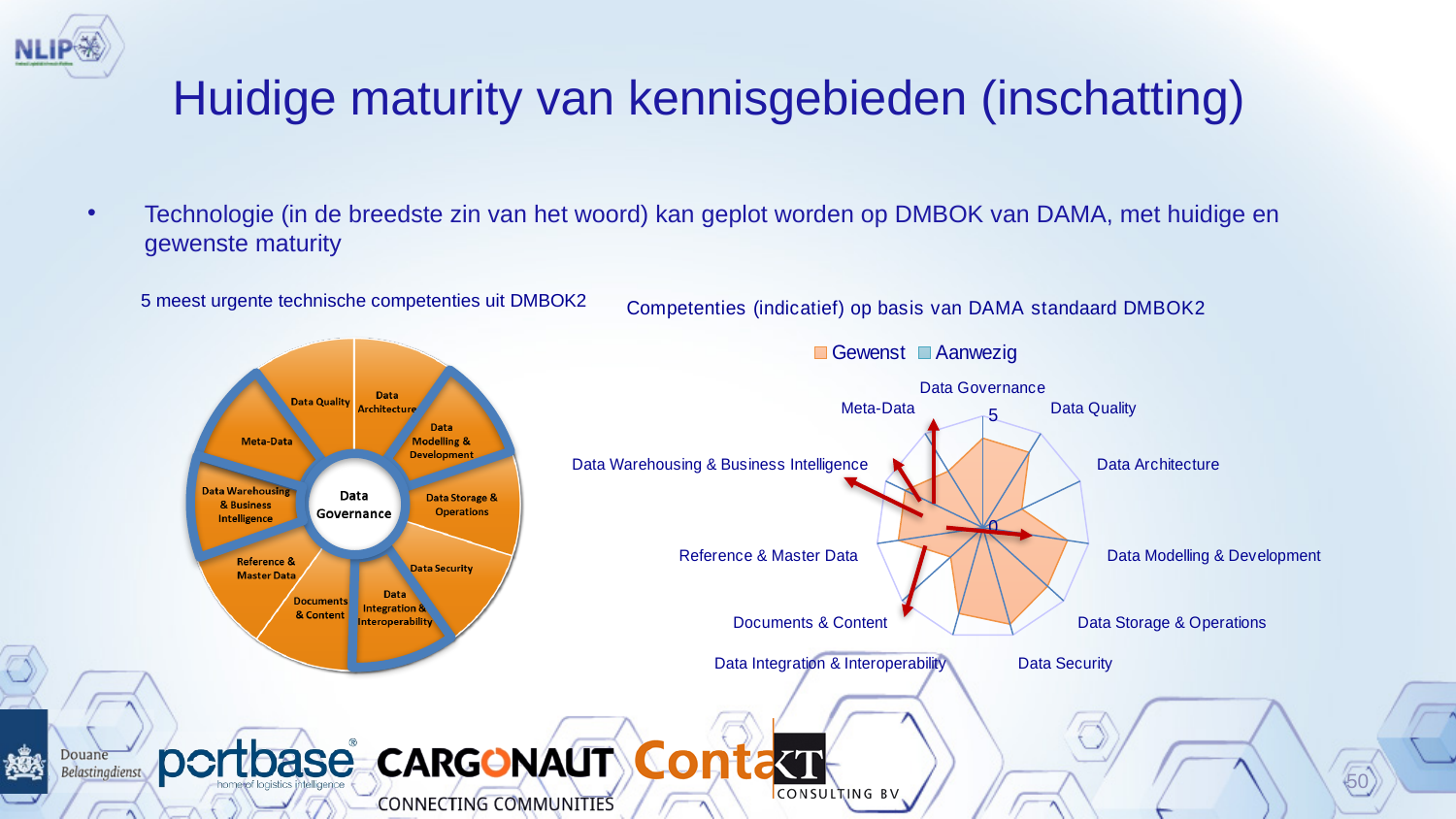
What kind of chart is the chart titled 'Competenties (indicatief) op basis van DAMA standaard DMBOK2'? Radar chart What is the maximum value shown on the axis of the radar chart? 5 What is the minimum value shown on the axis of the radar chart? 0 What are the two series named in the legend of the radar chart? Gewenst and Aanwezig How many series does the legend of the radar chart list? 2 What is the title of the radar chart on the right of the slide? Competenties (indicatief) op basis van DAMA standaard DMBOK2 How many categories (competence areas) are plotted on the radar chart? 11